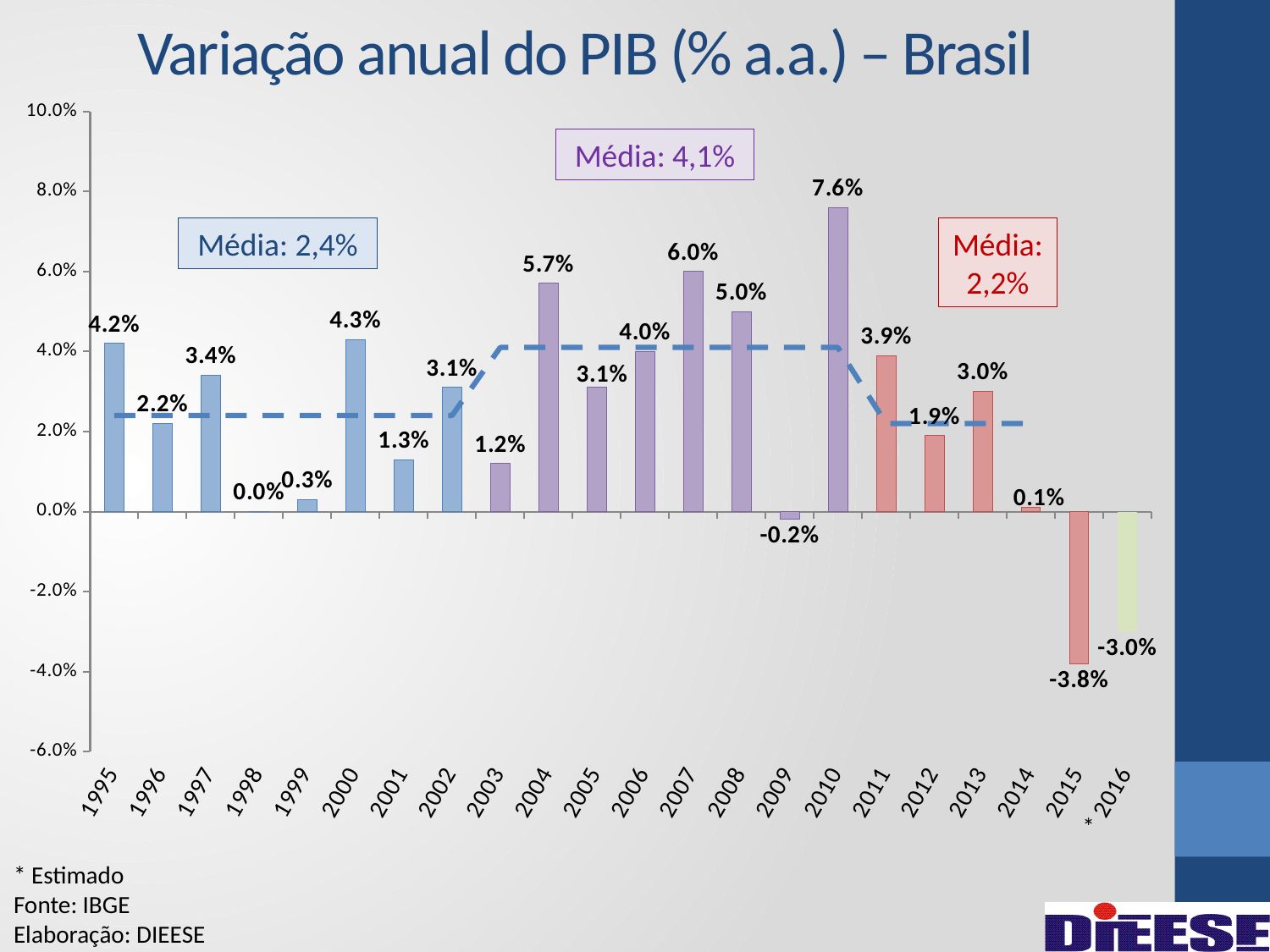
What average (Média) is shown in the purple box for the middle period? 4,1% Which year has the highest GDP variation on the chart? 2010 How many years are plotted on the x axis? 22 Do the values rise or fall from 2010 to 2015? Fall What kind of chart is shown on the slide? Combination bar and line chart (bars with a dashed average line) What is the value plotted for 2015? -3.8% Which year has the lowest GDP variation on the chart? 2015 What is the GDP variation shown for 2010? 7.6% What is the value shown for 2004? 5.7% Is the value for 2008 greater or less than 4.0%? greater What is the difference between the values for 2010 and 2007? 1.6 percentage points Which year has the larger value, 2000 or 1995? 2000